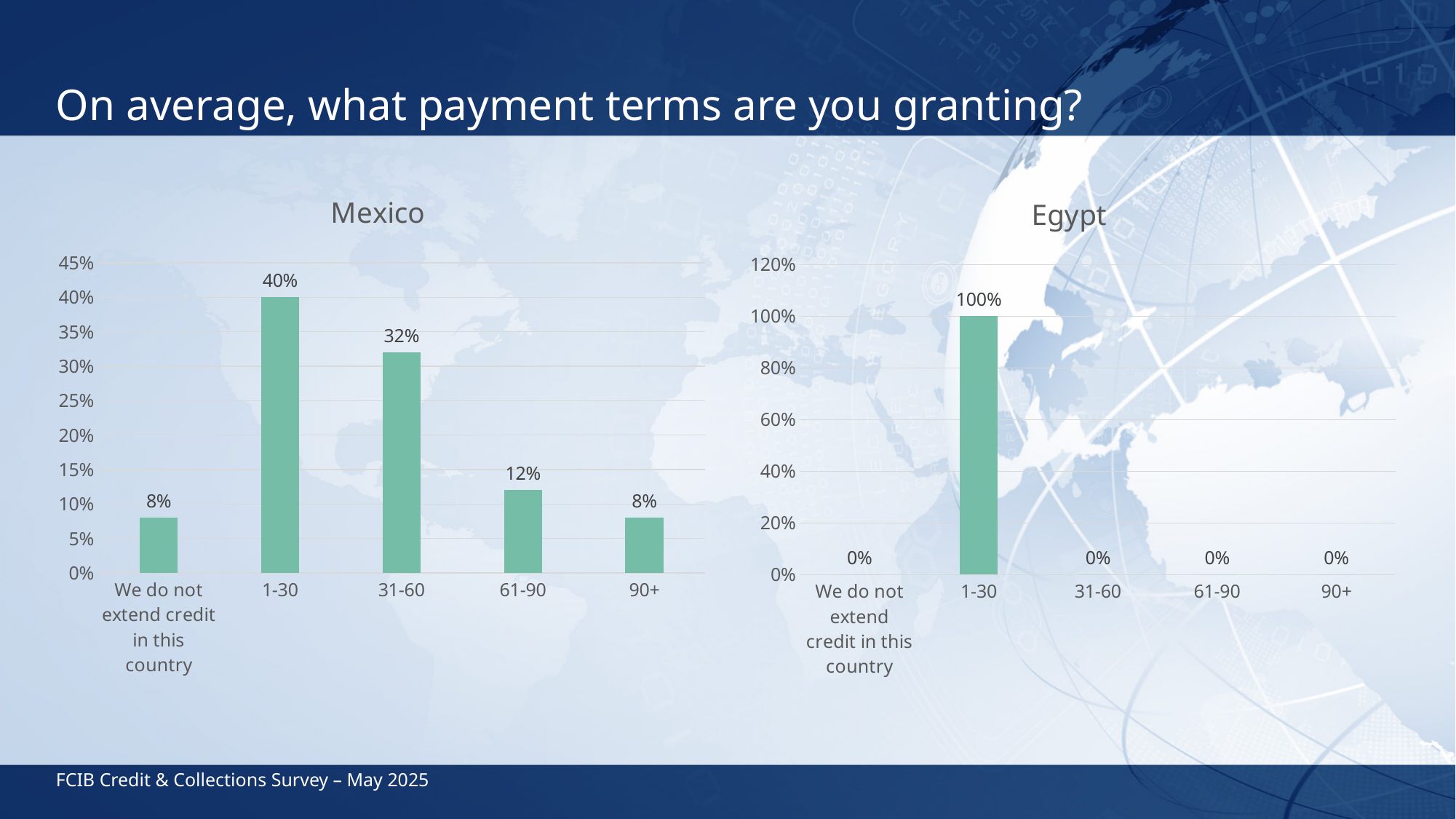
In the Mexico chart, which is larger, the value for 61-90 or the value for 90+? 61-90 What is the title of the chart on the left side of the slide? Mexico What kind of chart is the Egypt chart? Bar chart In the Mexico chart, what is the difference between the values for 1-30 and 31-60? 8% In the Mexico chart, how many categories are shown on the x axis? 5 In the Egypt chart, what is the value for 31-60? 0% In the Mexico chart, what is the value for 'We do not extend credit in this country'? 8% In the Mexico chart, what is the value for 1-30? 40% In the Egypt chart, what is the value for 1-30? 100% In the Egypt chart, which category has the highest value? 1-30 In the Mexico chart, what is the value for 31-60? 32% In the Mexico chart, which category has the highest value? 1-30